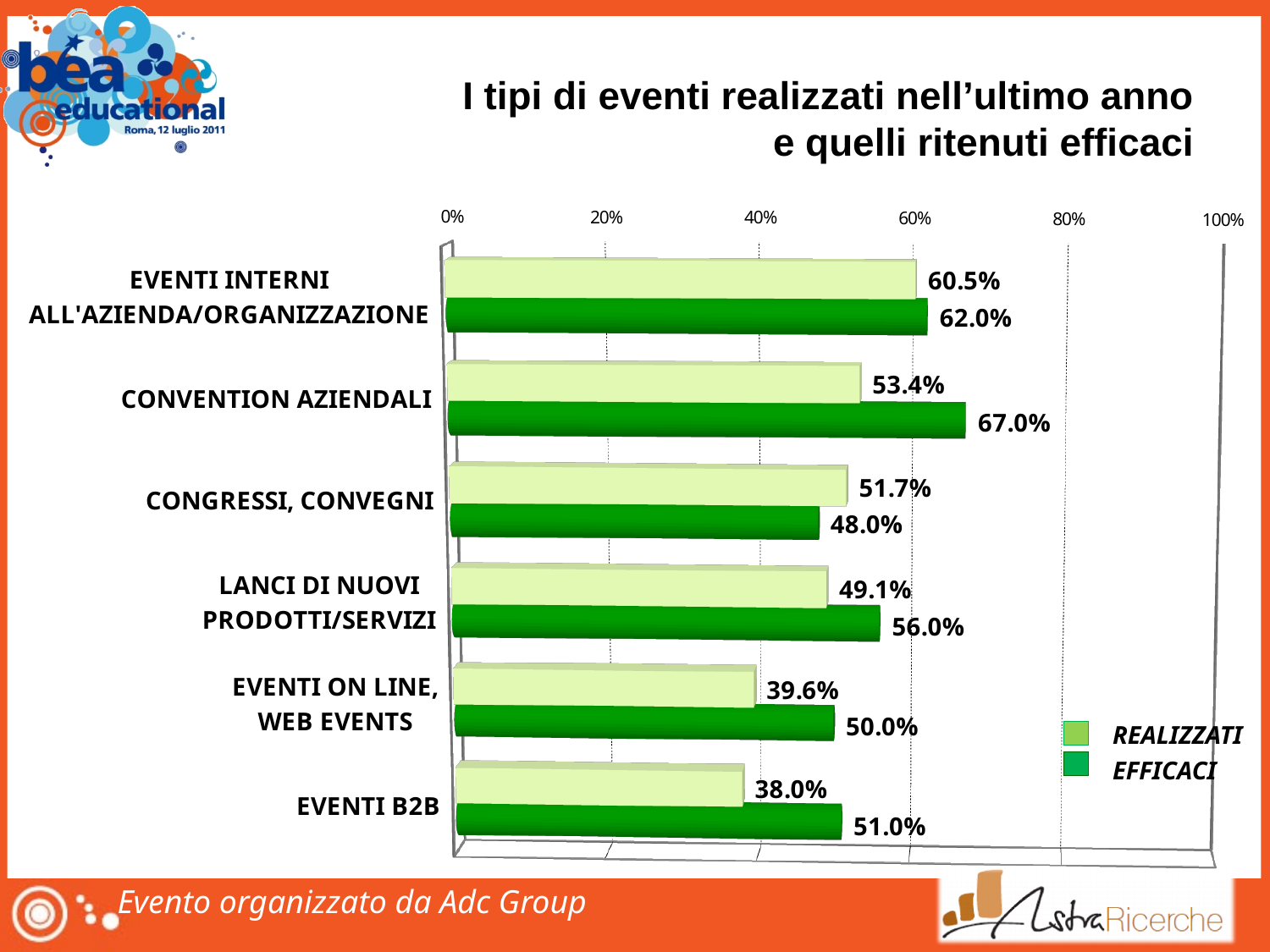
Which series is shown in dark green in the legend? EFFICACI What is the EFFICACI value for EVENTI B2B? 51.0% What is the REALIZZATI value for CONVENTION AZIENDALI? 53.4% For CONGRESSI, CONVEGNI, which is larger: the REALIZZATI value or the EFFICACI value? REALIZZATI Is the REALIZZATI value for EVENTI ON LINE, WEB EVENTS greater or less than 40%? less How many series does the legend list? 2 What is the difference between the EFFICACI and REALIZZATI values for CONVENTION AZIENDALI? 13.6% What kind of chart is shown on the slide? bar chart Which category has the highest EFFICACI value? CONVENTION AZIENDALI How many categories are shown on the chart? 6 What is the EFFICACI value for EVENTI INTERNI ALL'AZIENDA/ORGANIZZAZIONE? 62.0% Which category has the lowest REALIZZATI value? EVENTI B2B